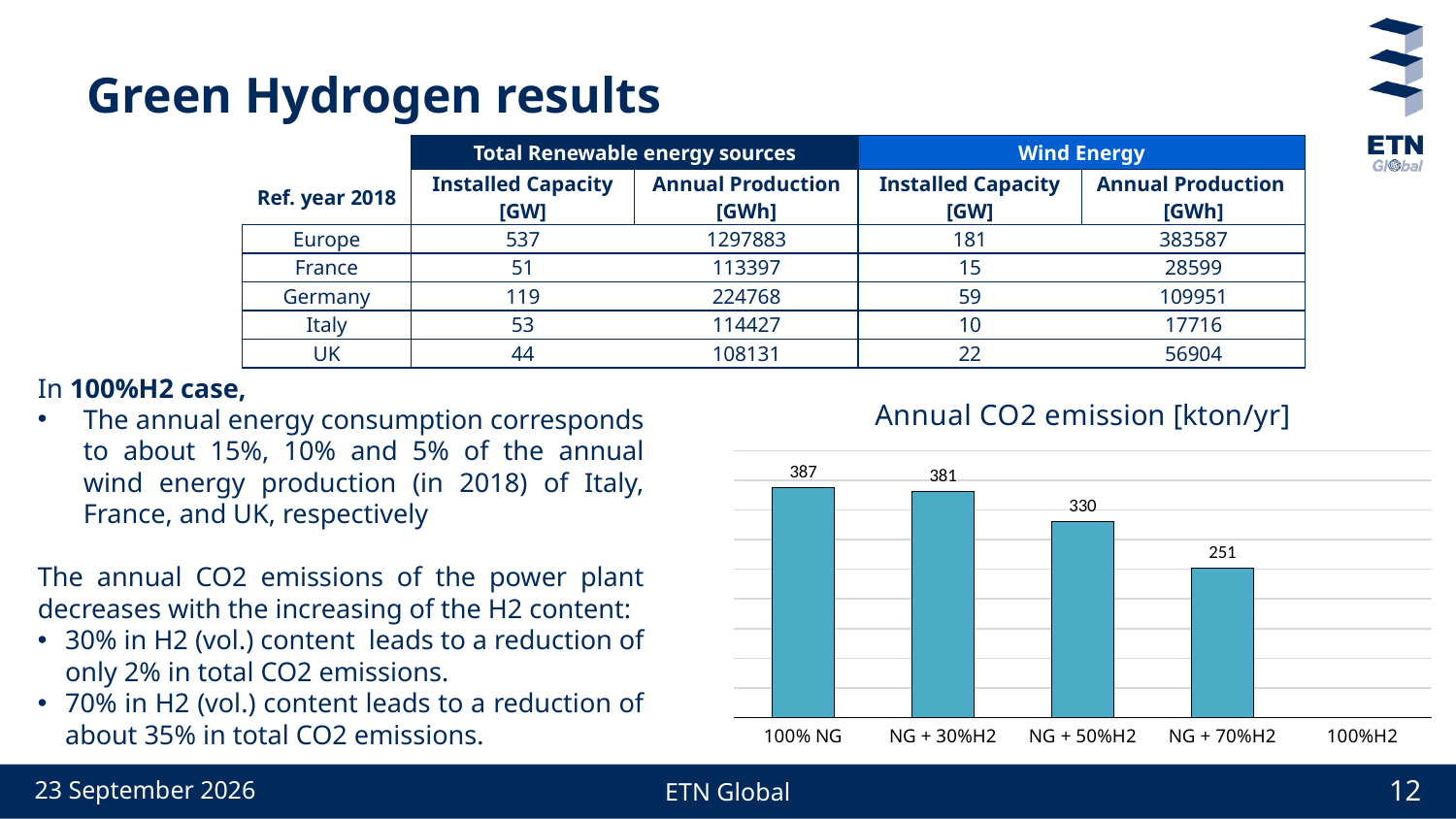
What is the annual CO2 emission for the 100% NG case? 387 Which case has the highest annual CO2 emission in the chart? 100% NG What is the annual CO2 emission for the NG + 30%H2 case? 381 What is the annual CO2 emission for the NG + 70%H2 case? 251 What is the annual CO2 emission for the NG + 50%H2 case? 330 What is the difference in annual CO2 emission between the 100% NG case and the NG + 70%H2 case? 136 Which has a larger annual CO2 emission, NG + 50%H2 or NG + 70%H2? NG + 50%H2 What kind of chart is used to show the annual CO2 emission? Bar chart How many categories are shown on the x axis of the chart? 5 Among the cases with a visible bar, which has the lowest annual CO2 emission? NG + 70%H2 What is the difference in annual CO2 emission between the NG + 30%H2 case and the NG + 50%H2 case? 51 Do the annual CO2 emission values rise or fall from left to right along the x axis? Fall